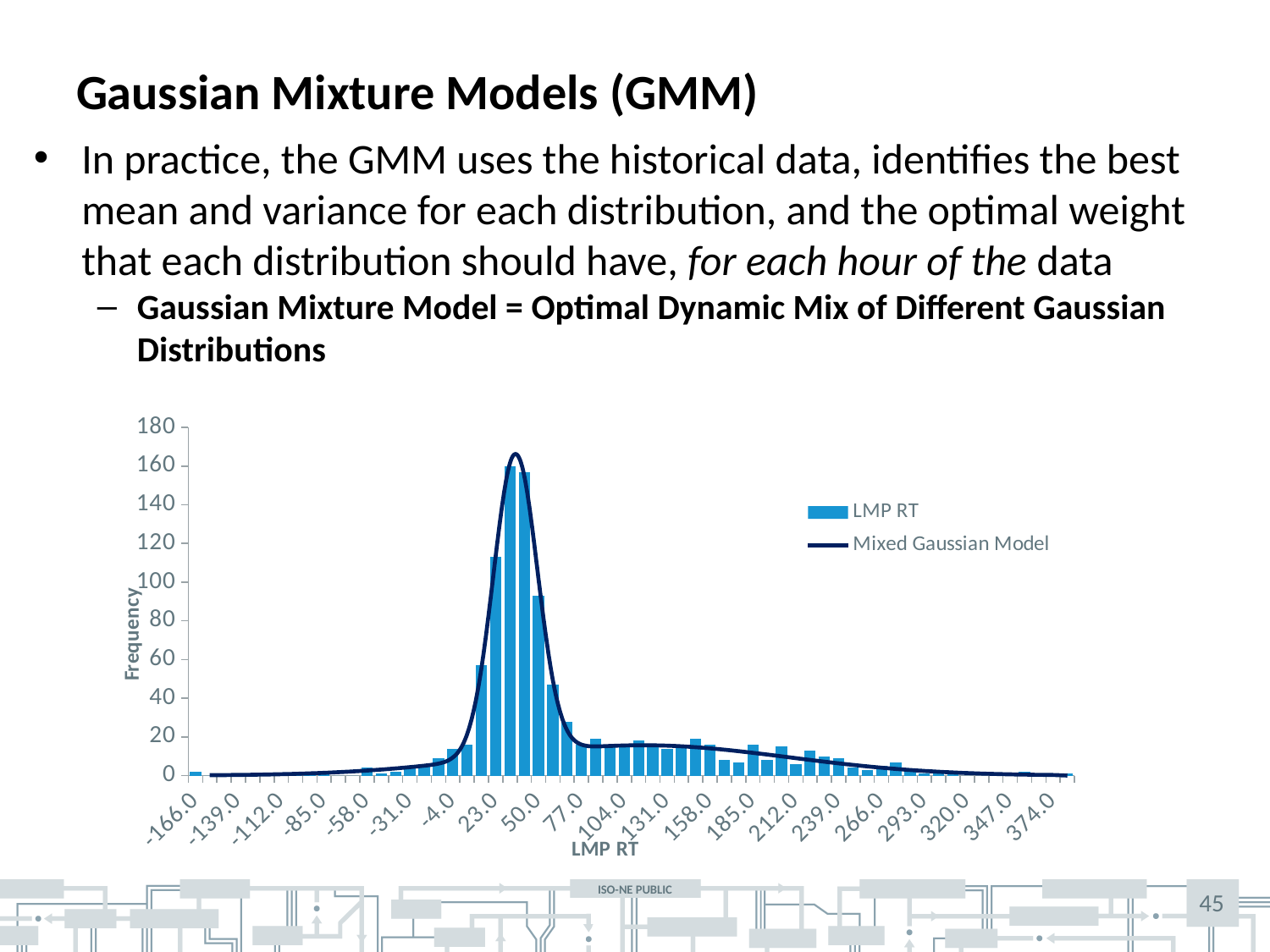
Is the tallest bar in the chart greater or less than 140? greater What are the two entries in the chart legend? LMP RT and Mixed Gaussian Model Is the peak of the Mixed Gaussian Model line greater or less than 140? greater How many series does the chart legend list? 2 What kind of chart is shown on the slide? A bar chart (histogram) with a line overlay Is the bar at 374.0 greater or less than 20? less Which is taller: the bar at 104.0 or the bar at 293.0? 104.0 What is the title of the vertical axis of the chart? Frequency Do the bar heights generally rise or fall moving along the x axis from 50.0 to 374.0? fall How many labelled tick values are shown on the x axis of the chart? 21